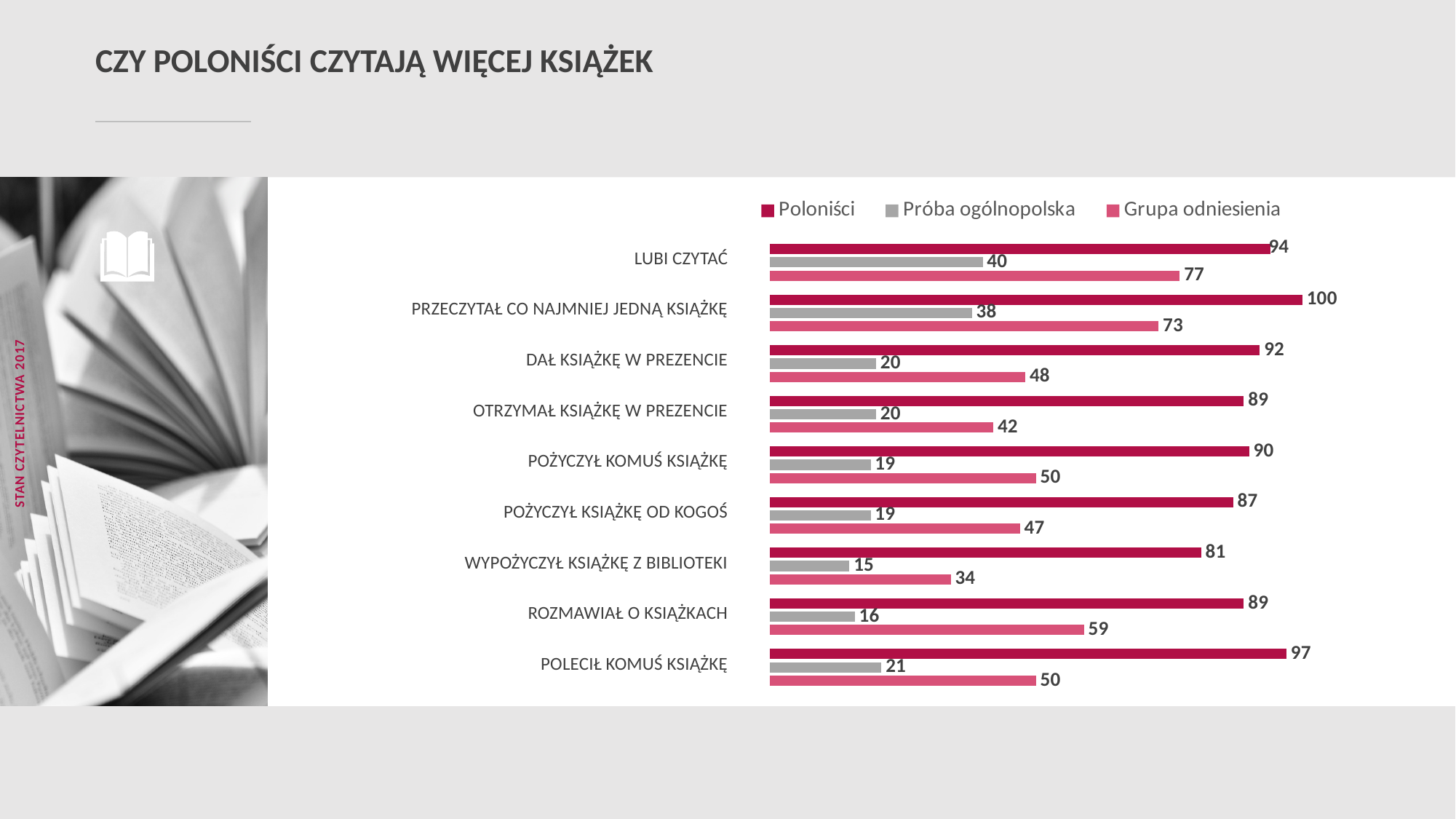
Which category has the highest value for Poloniści? PRZECZYTAŁ CO NAJMNIEJ JEDNĄ KSIĄŻKĘ Which category has the lowest value for Grupa odniesienia? WYPOŻYCZYŁ KSIĄŻKĘ Z BIBLIOTEKI Which category has the lowest value for Próba ogólnopolska? WYPOŻYCZYŁ KSIĄŻKĘ Z BIBLIOTEKI How many categories are shown in the chart? 9 How many series does the legend list? 3 What is the title of the slide? CZY POLONIŚCI CZYTAJĄ WIĘCEJ KSIĄŻEK Which is larger: the Grupa odniesienia value for LUBI CZYTAĆ or for PRZECZYTAŁ CO NAJMNIEJ JEDNĄ KSIĄŻKĘ? LUBI CZYTAĆ What kind of chart is shown on the slide? Bar chart What is the value for Próba ogólnopolska in the WYPOŻYCZYŁ KSIĄŻKĘ Z BIBLIOTEKI category? 15 What is the difference between the Poloniści and Próba ogólnopolska values in the DAŁ KSIĄŻKĘ W PREZENCIE category? 72 What is the value for Grupa odniesienia in the ROZMAWIAŁ O KSIĄŻKACH category? 59 What is the value for Poloniści in the LUBI CZYTAĆ category? 94